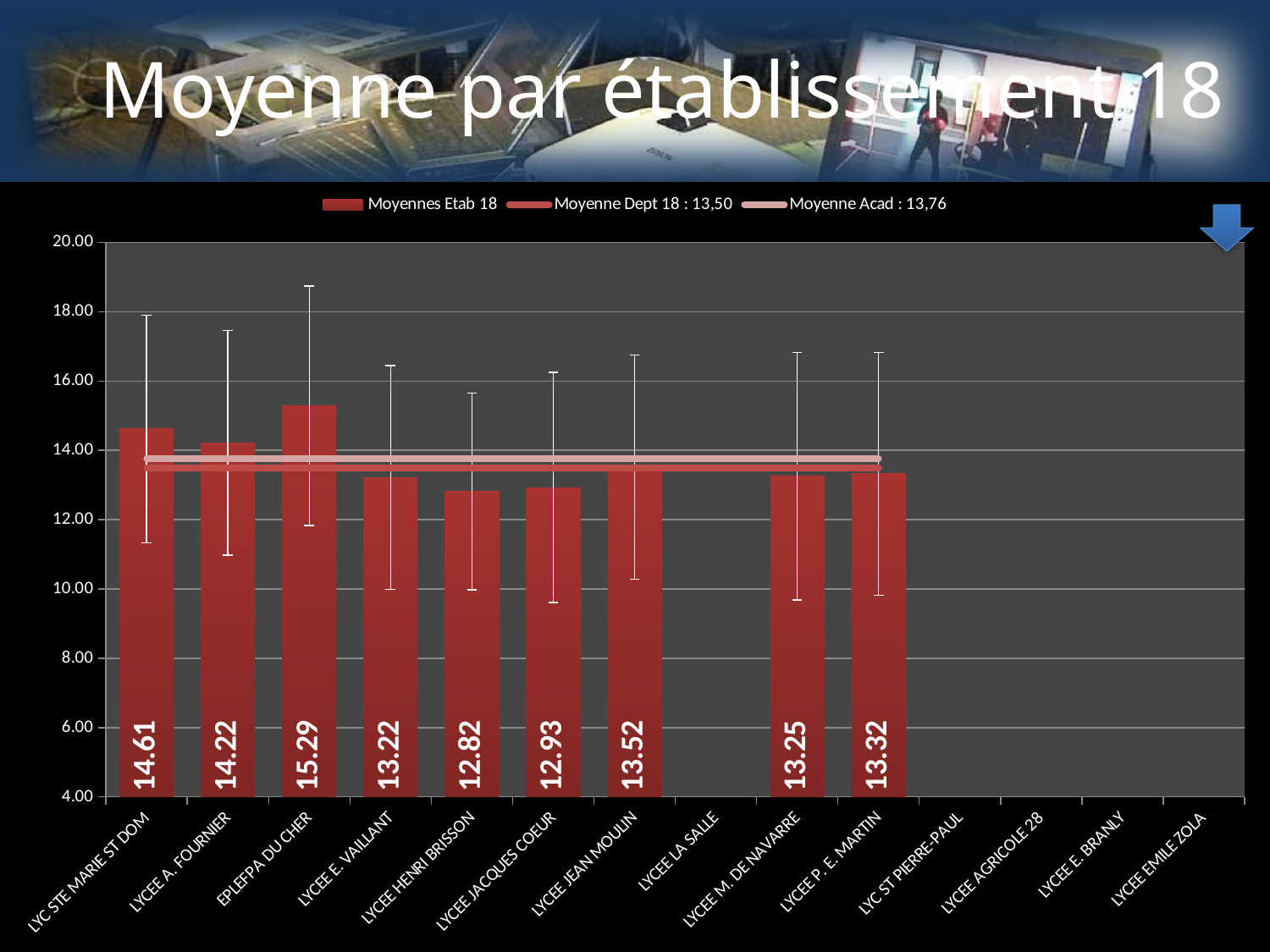
Which establishment has the highest average? EPLEFPA DU CHER How many bars with data labels are shown in the chart? 9 What is the value for EPLEFPA DU CHER? 15.29 What kind of chart is shown on the slide? bar chart Which is larger, the value for LYCEE JEAN MOULIN or the value for LYCEE E. VAILLANT? LYCEE JEAN MOULIN What value does the legend give for Moyenne Acad? 13,76 Which establishment with a labelled bar has the lowest average? LYCEE HENRI BRISSON What is the difference between the values for LYC STE MARIE ST DOM and LYCEE A. FOURNIER? 0.39 What value does the legend give for Moyenne Dept 18? 13,50 What is the value for LYCEE HENRI BRISSON? 12.82 How many series does the legend list? 3 What is the value for LYCEE P. E. MARTIN? 13.32